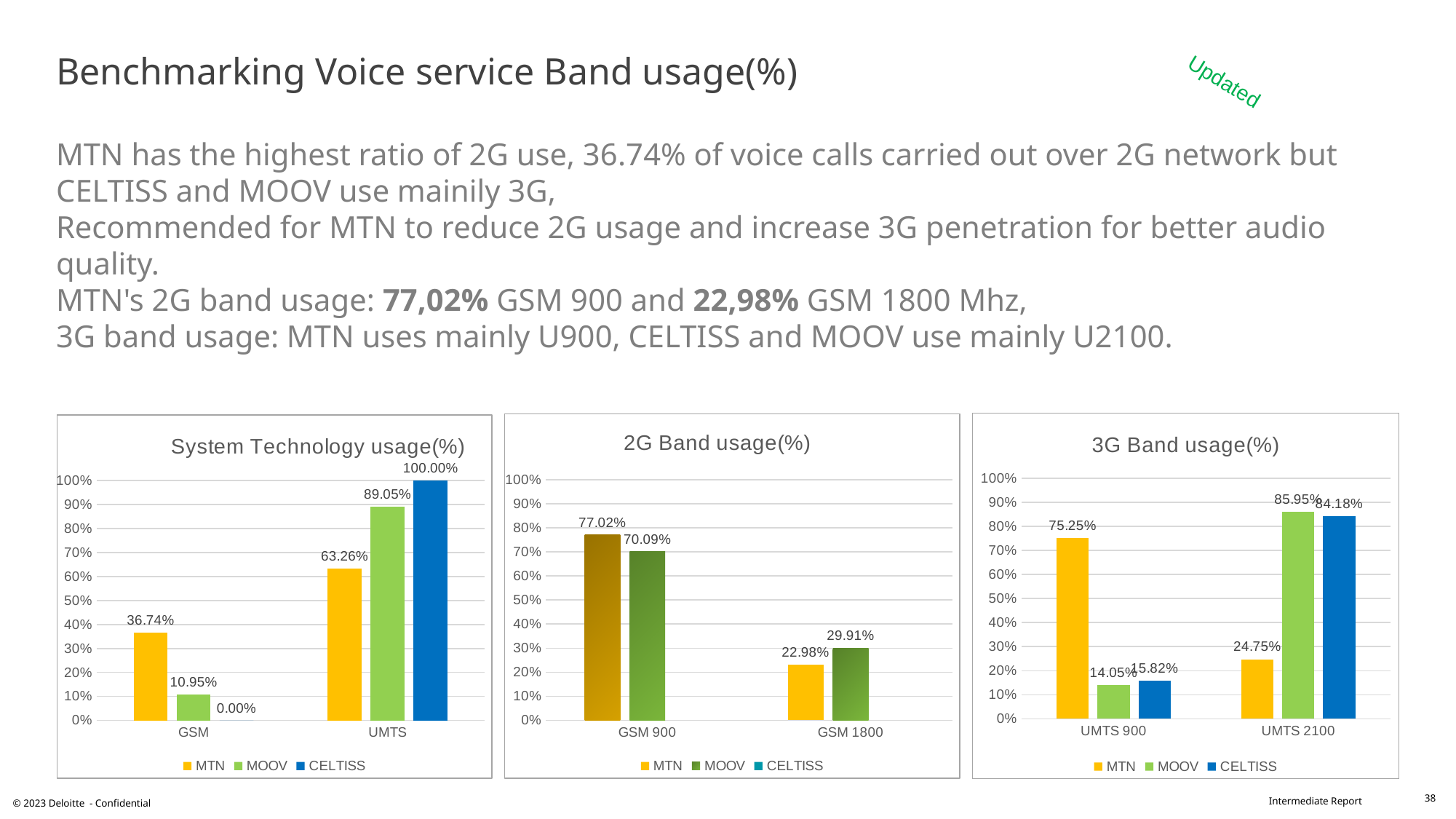
What kind of chart is the '3G Band usage(%)' chart? Bar chart In the 'System Technology usage(%)' chart, which operator has the lowest value in the GSM category? CELTISS In the '3G Band usage(%)' chart, what is the difference between CELTISS's UMTS 900 value and MOOV's UMTS 900 value? 1.77% In the 'System Technology usage(%)' chart, what is the difference between MOOV's UMTS value and MTN's UMTS value? 25.79% How many categories are shown on the x axis of the '2G Band usage(%)' chart? 2 In the '2G Band usage(%)' chart, which operator has the higher value in the GSM 1800 category, MTN or MOOV? MOOV In the '3G Band usage(%)' chart, which operator has the highest value in the UMTS 2100 category? MOOV In the '2G Band usage(%)' chart, how many series does the legend list? 3 In the 'System Technology usage(%)' chart, what is the value for MTN in the GSM category? 36.74% In the 'System Technology usage(%)' chart, what is the value for CELTISS in the UMTS category? 100.00% In the '3G Band usage(%)' chart, what is the value for MTN in the UMTS 900 category? 75.25% In the '2G Band usage(%)' chart, what is the value for MOOV in the GSM 900 category? 70.09%